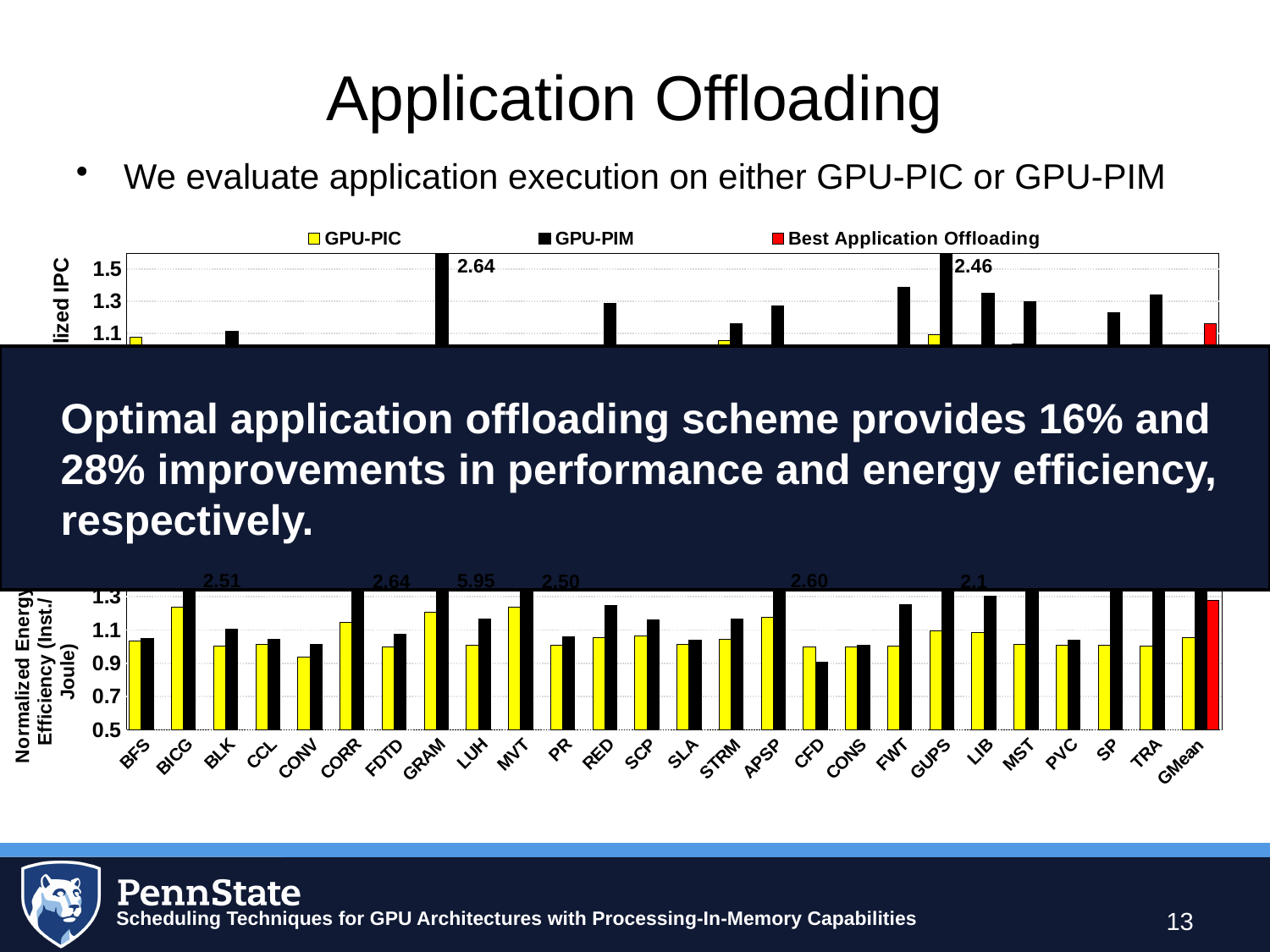
How many categories are shown on the x axis of the bottom chart (Normalized Energy Efficiency)? 26 In the bottom chart (Normalized Energy Efficiency), what is the GPU-PIM value for BICG? 2.51 In the bottom chart (Normalized Energy Efficiency), is the GPU-PIC value for BICG greater or less than 1.1? greater In the bottom chart (Normalized Energy Efficiency), which is larger: the GPU-PIM value for CORR or for MVT? CORR In the bottom chart (Normalized Energy Efficiency), is the GPU-PIC value for CONV greater or less than 1.1? less In the bottom chart (Normalized Energy Efficiency), what is the GPU-PIM value for GUPS? 2.1 How many series does the legend list for the charts on this slide? 3 In the bottom chart (Normalized Energy Efficiency), what is the GPU-PIM value for APSP? 2.60 In the bottom chart (Normalized Energy Efficiency), which category has the highest GPU-PIM value? GRAM What kind of chart is the bottom chart (Normalized Energy Efficiency)? Bar chart